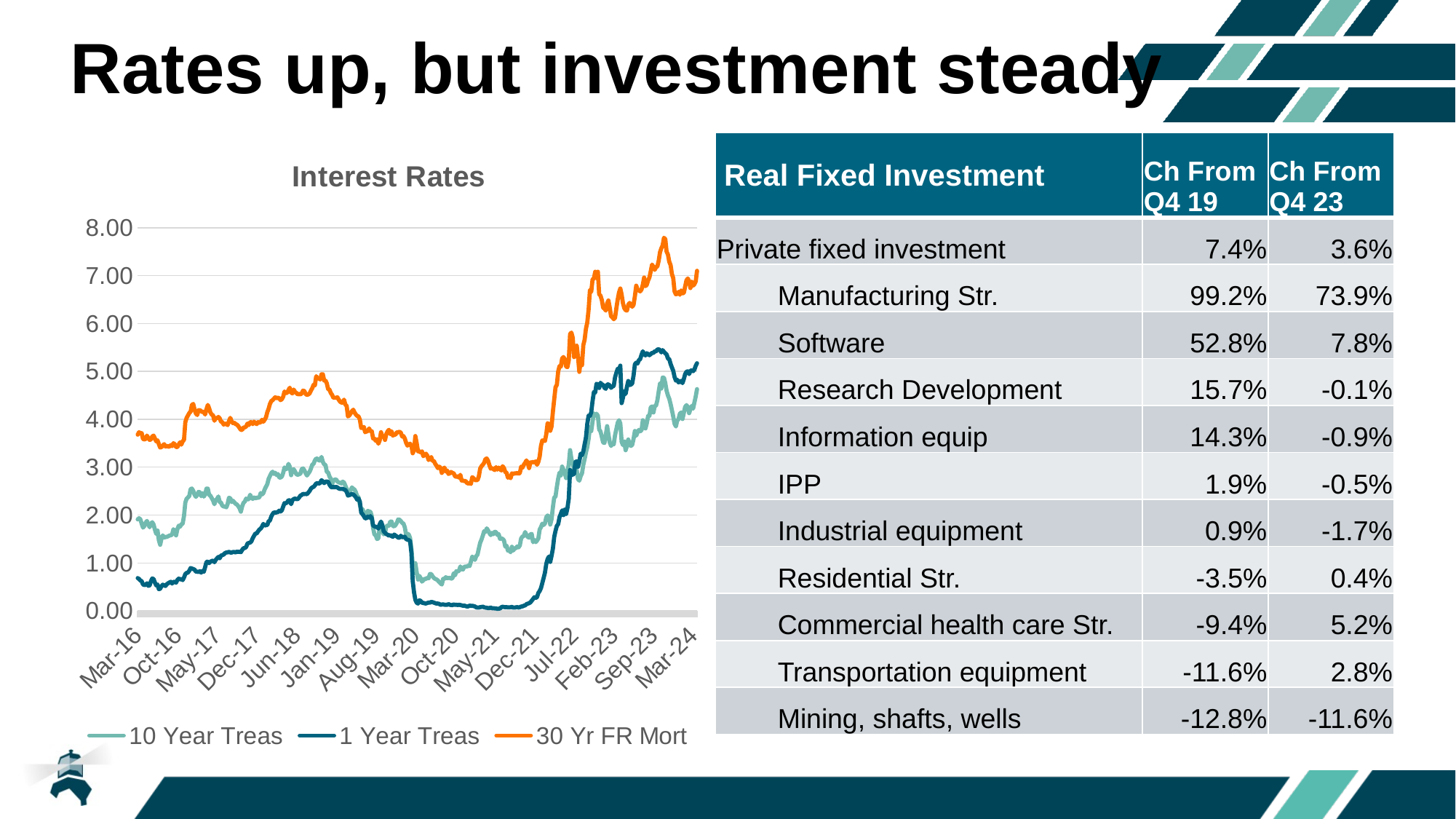
What kind of chart is the Interest Rates chart? line chart In the Interest Rates chart, is the value for 1 Year Treas at Mar-24 greater or less than 4.00? greater How many series does the legend of the Interest Rates chart list? 3 In the Interest Rates chart, is the value for 30 Yr FR Mort at Mar-24 greater or less than 6.00? greater In the Interest Rates chart, which series has the highest values across the whole period? 30 Yr FR Mort In the Interest Rates chart, is the value for 10 Year Treas at Mar-16 greater or less than 3.00? less In the Interest Rates chart, which series has the lowest value around Oct-20? 1 Year Treas Which series in the Interest Rates chart is drawn in orange? 30 Yr FR Mort In the Interest Rates chart, at Mar-24, which is larger: 30 Yr FR Mort or 10 Year Treas? 30 Yr FR Mort In the Interest Rates chart, does the 1 Year Treas series rise or fall between Mar-20 and Oct-20? fall What is the title of the chart on the slide? Interest Rates